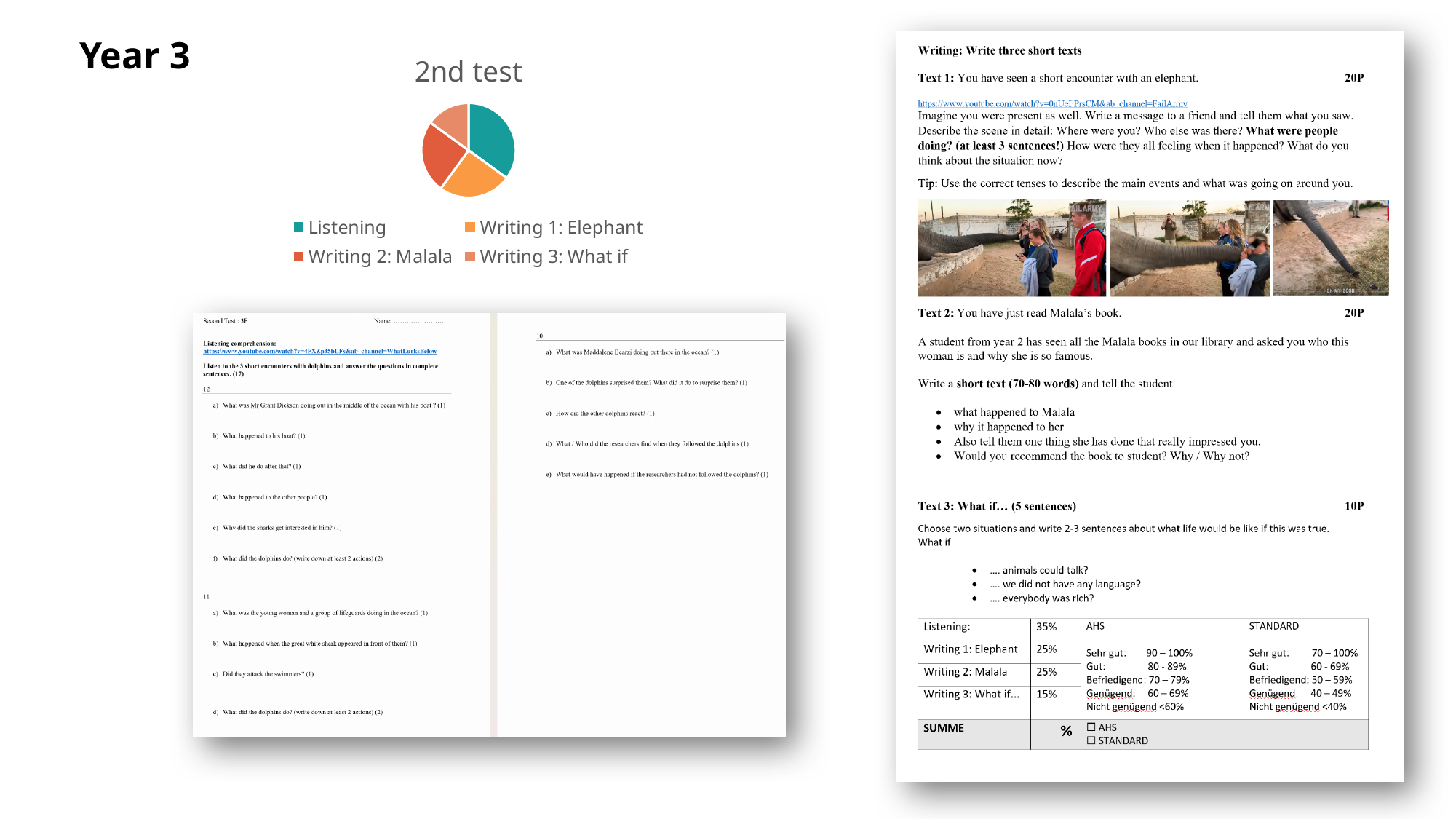
In the "2nd test" pie chart, which slice is larger: Listening or Writing 2: Malala? Listening In the "2nd test" pie chart, which slice is larger: Writing 1: Elephant or Writing 3: What if? Writing 1: Elephant What is the title of the pie chart on the slide? 2nd test In the "2nd test" pie chart, which slice is larger: Listening or Writing 3: What if? Listening Which category has the largest slice in the "2nd test" pie chart? Listening Which legend entry of the "2nd test" pie chart is shown in teal? Listening How many entries does the legend of the "2nd test" pie chart list? 4 Which category has the smallest slice in the "2nd test" pie chart? Writing 3: What if What kind of chart is shown under the title "2nd test"? pie chart How many slices does the "2nd test" pie chart have? 4